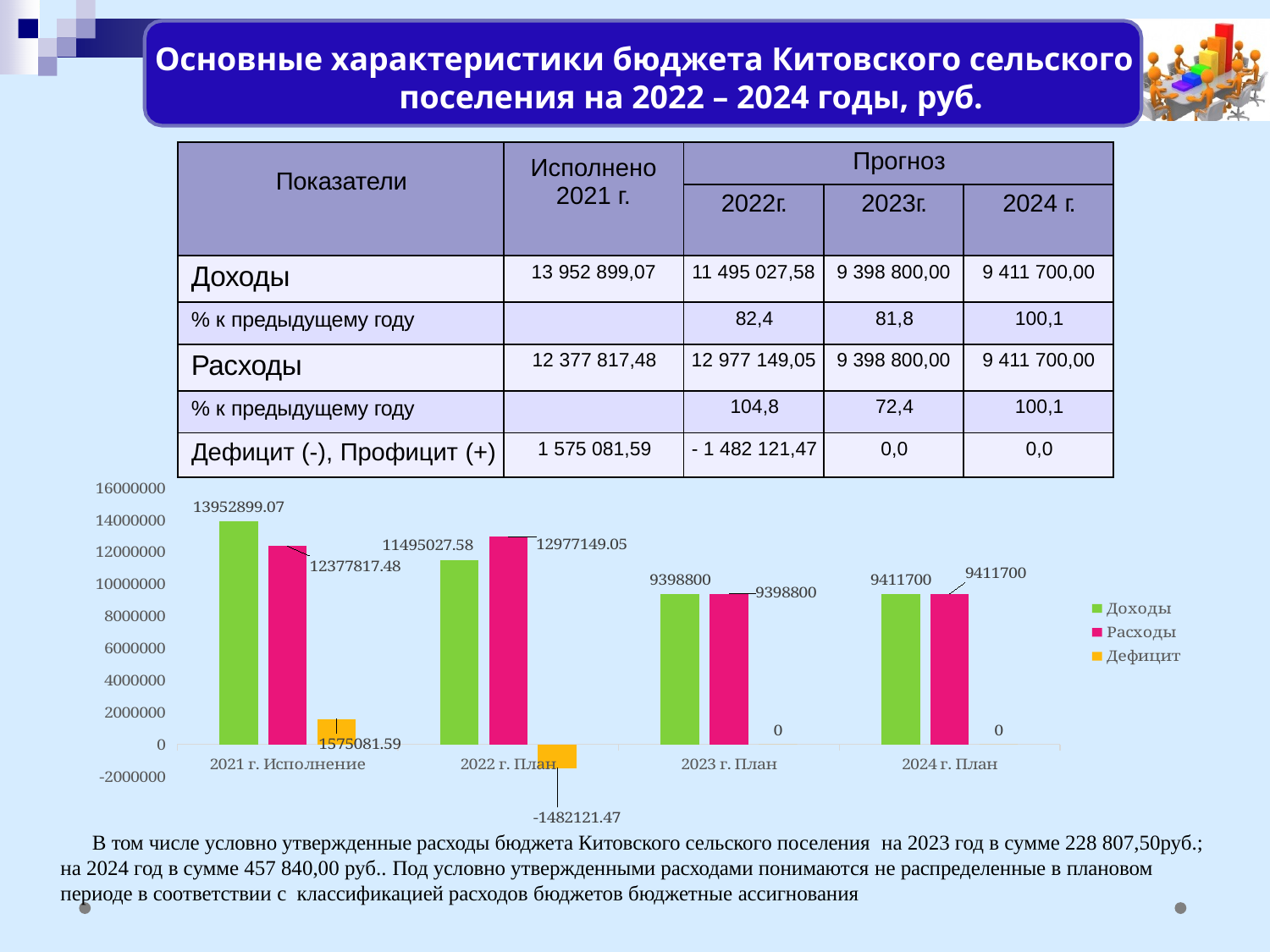
What kind of chart is shown on the slide? bar chart In the chart, which is larger for 2022 г. План: Доходы or Расходы? Расходы What is the difference between Доходы and Расходы for 2021 г. Исполнение in the chart? 1575081.59 Which category has the lowest Расходы value in the chart? 2023 г. План What is the value of Доходы for 2021 г. Исполнение in the chart? 13952899.07 How many categories are shown on the x axis of the chart? 4 What is the value of Доходы for 2024 г. План in the chart? 9411700 Which category has the highest Доходы value in the chart? 2021 г. Исполнение Which series in the chart legend is shown in green? Доходы What is the value of Расходы for 2022 г. План in the chart? 12977149.05 How many series does the chart legend list? 3 What is the value of Дефицит for 2022 г. План in the chart? -1482121.47